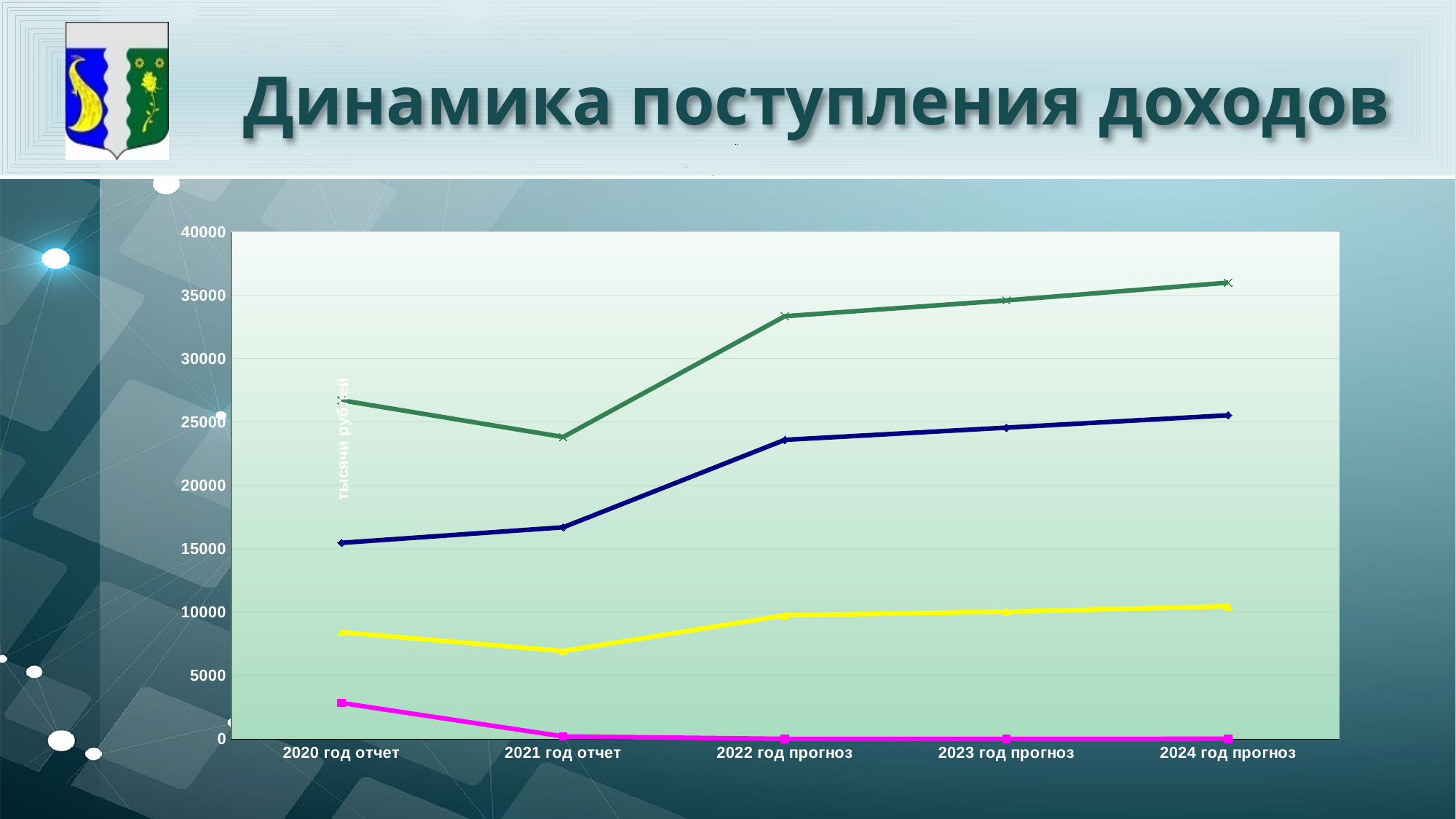
What is the label on the vertical axis of the chart? тысячи рублей Is the value of the green line for 2021 год отчет greater or less than 25000? less Which line is the lowest across all categories of the chart? the magenta line Is the value of the magenta line for 2020 год отчет greater or less than 5000? less What kind of chart is shown on the slide? line chart Does the dark blue line rise or fall from 2021 год отчет to 2024 год прогноз? rises How many categories are shown along the x axis of the chart? 5 Which line is the highest across all categories of the chart? the green line Is the value of the yellow line for 2021 год отчет greater or less than 10000? less What is the title of the chart on the slide? Динамика поступления доходов